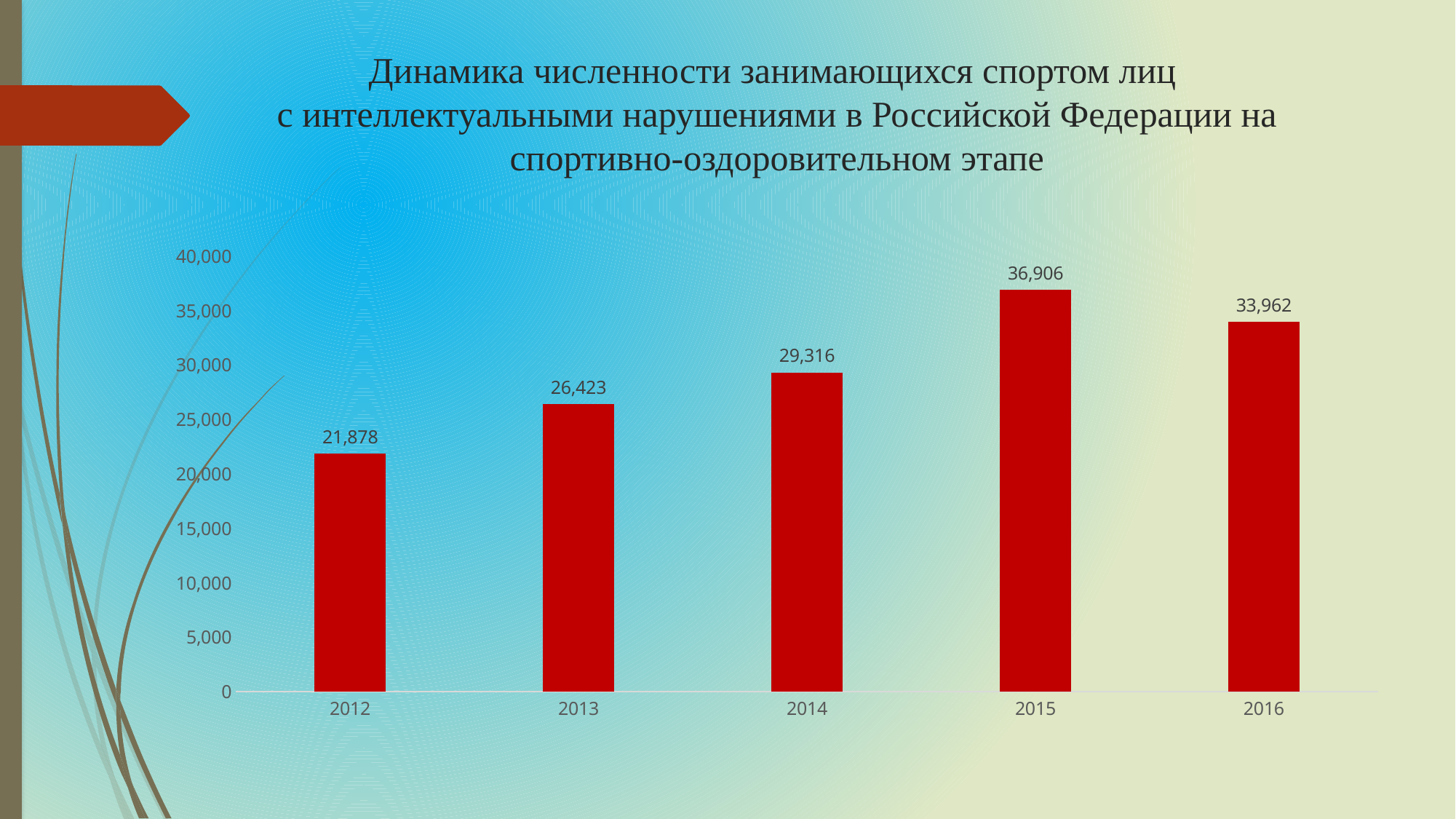
What is the value for 2014? 29,316 Which is larger, the value for 2014 or the value for 2016? 2016 Is the value for 2013 greater or less than 25,000? greater What kind of chart is shown on the slide? bar chart How many years are shown on the x axis? 5 What is the value for 2016? 33,962 What is the value for 2012? 21,878 What is the difference between the values for 2013 and 2012? 4,545 What is the difference between the values for 2015 and 2016? 2,944 Which year has the lowest value? 2012 Do the values rise or fall from 2012 to 2015? rise Which year has the highest value? 2015